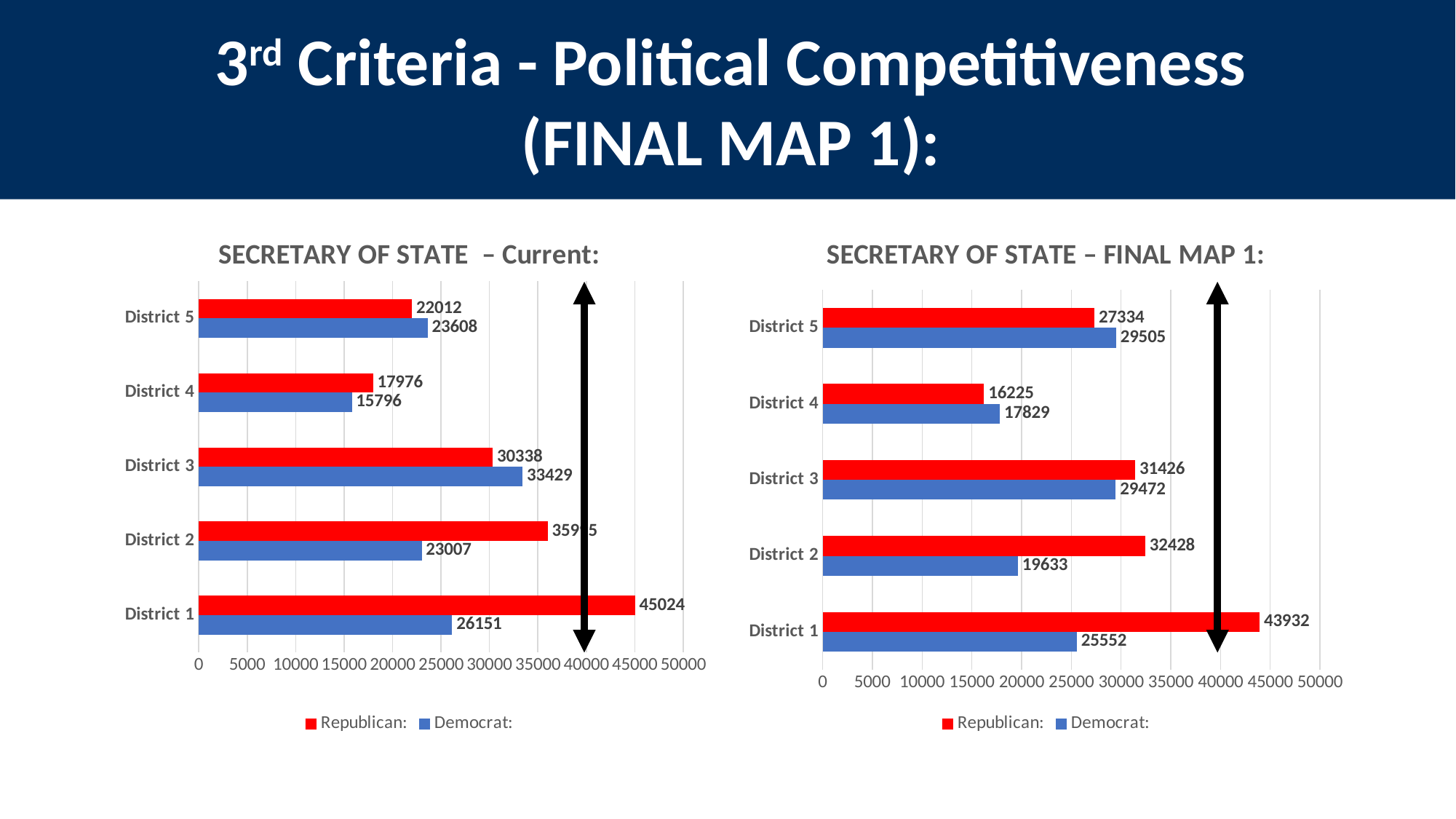
In the 'SECRETARY OF STATE – Current' chart, what is the Democrat value for District 3? 33429 In the 'SECRETARY OF STATE – FINAL MAP 1' chart, what is the difference between the Republican and Democrat values for District 2? 12795 In the 'SECRETARY OF STATE – FINAL MAP 1' chart, what is the Republican value for District 4? 16225 In the 'SECRETARY OF STATE – Current' chart, what is the difference between the Democrat and Republican values for District 5? 1596 In the 'SECRETARY OF STATE – FINAL MAP 1' chart, which is larger for District 3, the Republican value or the Democrat value? Republican What type of chart is the 'SECRETARY OF STATE – Current' chart? Bar chart In the 'SECRETARY OF STATE – FINAL MAP 1' chart, which district has the highest Republican value? District 1 In the 'SECRETARY OF STATE – FINAL MAP 1' chart, what is the Democrat value for District 5? 29505 How many series does the legend of the 'SECRETARY OF STATE – FINAL MAP 1' chart list? 2 In the 'SECRETARY OF STATE – Current' chart, which district has the lowest Democrat value? District 4 How many districts are shown in the 'SECRETARY OF STATE – Current' chart? 5 In the 'SECRETARY OF STATE – Current' chart, what is the Republican value for District 1? 45024